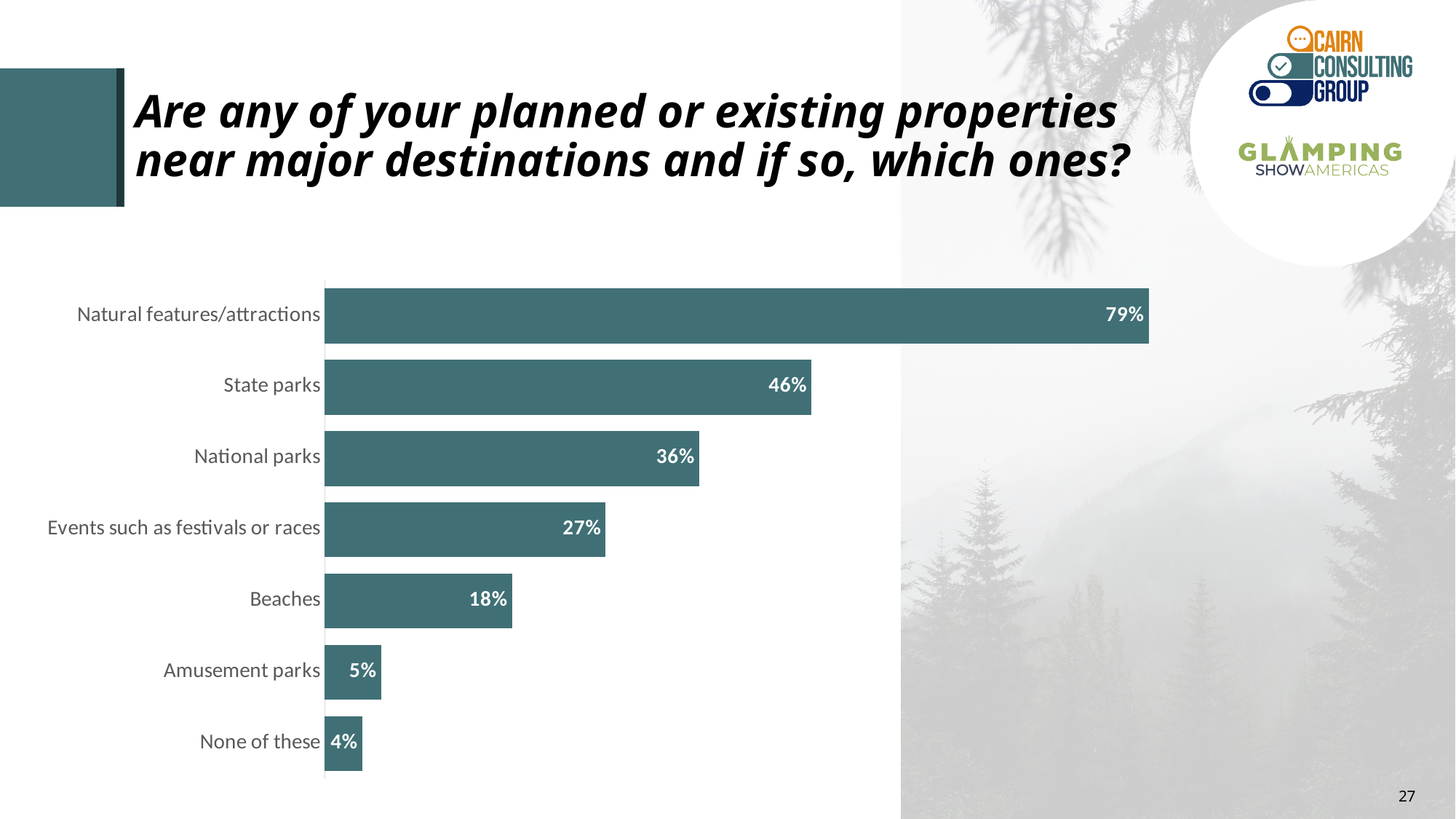
What type of chart is shown on the slide? Bar chart What is the value shown for Events such as festivals or races? 27% What is the difference between the values for Natural features/attractions and Events such as festivals or races? 52% What is the difference between the values for State parks and National parks? 10% Which category has the lowest value in the chart? None of these What percentage of respondents said their properties are near natural features/attractions? 79% How many categories are shown in the chart? 7 What is the value shown for State parks? 46% Which has a larger value, National parks or Beaches? National parks Which has a larger value, Amusement parks or None of these? Amusement parks Which category has the highest value in the chart? Natural features/attractions What percentage is shown for Beaches? 18%